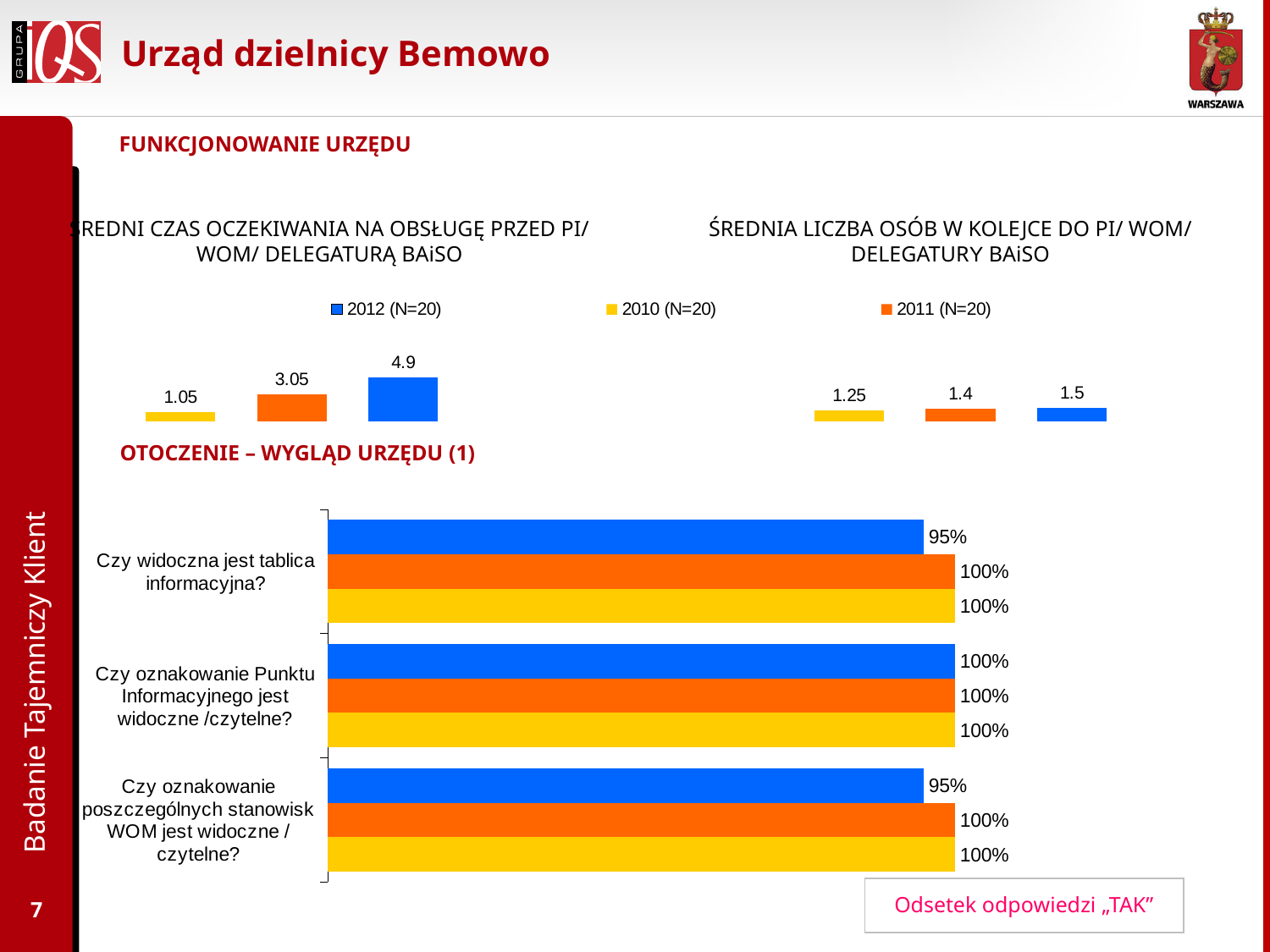
In the chart titled 'ŚREDNI CZAS OCZEKIWANIA NA OBSŁUGĘ PRZED PI/ WOM/ DELEGATURĄ BAiSO', which year has the highest value? 2012 (N=20) In the chart titled 'ŚREDNI CZAS OCZEKIWANIA NA OBSŁUGĘ PRZED PI/ WOM/ DELEGATURĄ BAiSO', what is the value for 2012 (N=20)? 4.9 What type of chart is the bottom chart (OTOCZENIE – WYGLĄD URZĘDU)? Bar chart In the bottom chart (OTOCZENIE – WYGLĄD URZĘDU), what is the 2011 value for 'Czy oznakowanie poszczególnych stanowisk WOM jest widoczne / czytelne?'? 100% In the chart titled 'ŚREDNIA LICZBA OSÓB W KOLEJCE DO PI/ WOM/ DELEGATURY BAiSO', what is the value for 2011 (N=20)? 1.4 In the bottom chart (OTOCZENIE – WYGLĄD URZĘDU), which is larger for 'Czy oznakowanie poszczególnych stanowisk WOM jest widoczne / czytelne?': the 2012 value or the 2010 value? 2010 In the bottom chart (OTOCZENIE – WYGLĄD URZĘDU), how many question categories are shown? 3 In the chart titled 'ŚREDNIA LICZBA OSÓB W KOLEJCE DO PI/ WOM/ DELEGATURY BAiSO', what is the difference between the 2012 and 2010 values? 0.25 In the bottom chart (OTOCZENIE – WYGLĄD URZĘDU), what is the 2012 value for 'Czy widoczna jest tablica informacyjna?'? 95% In the chart titled 'ŚREDNI CZAS OCZEKIWANIA NA OBSŁUGĘ PRZED PI/ WOM/ DELEGATURĄ BAiSO', what is the difference between the 2012 and 2011 values? 1.85 In the chart titled 'ŚREDNIA LICZBA OSÓB W KOLEJCE DO PI/ WOM/ DELEGATURY BAiSO', which year has the lowest value? 2010 (N=20) In the chart titled 'ŚREDNI CZAS OCZEKIWANIA NA OBSŁUGĘ PRZED PI/ WOM/ DELEGATURĄ BAiSO', what is the value for 2010 (N=20)? 1.05